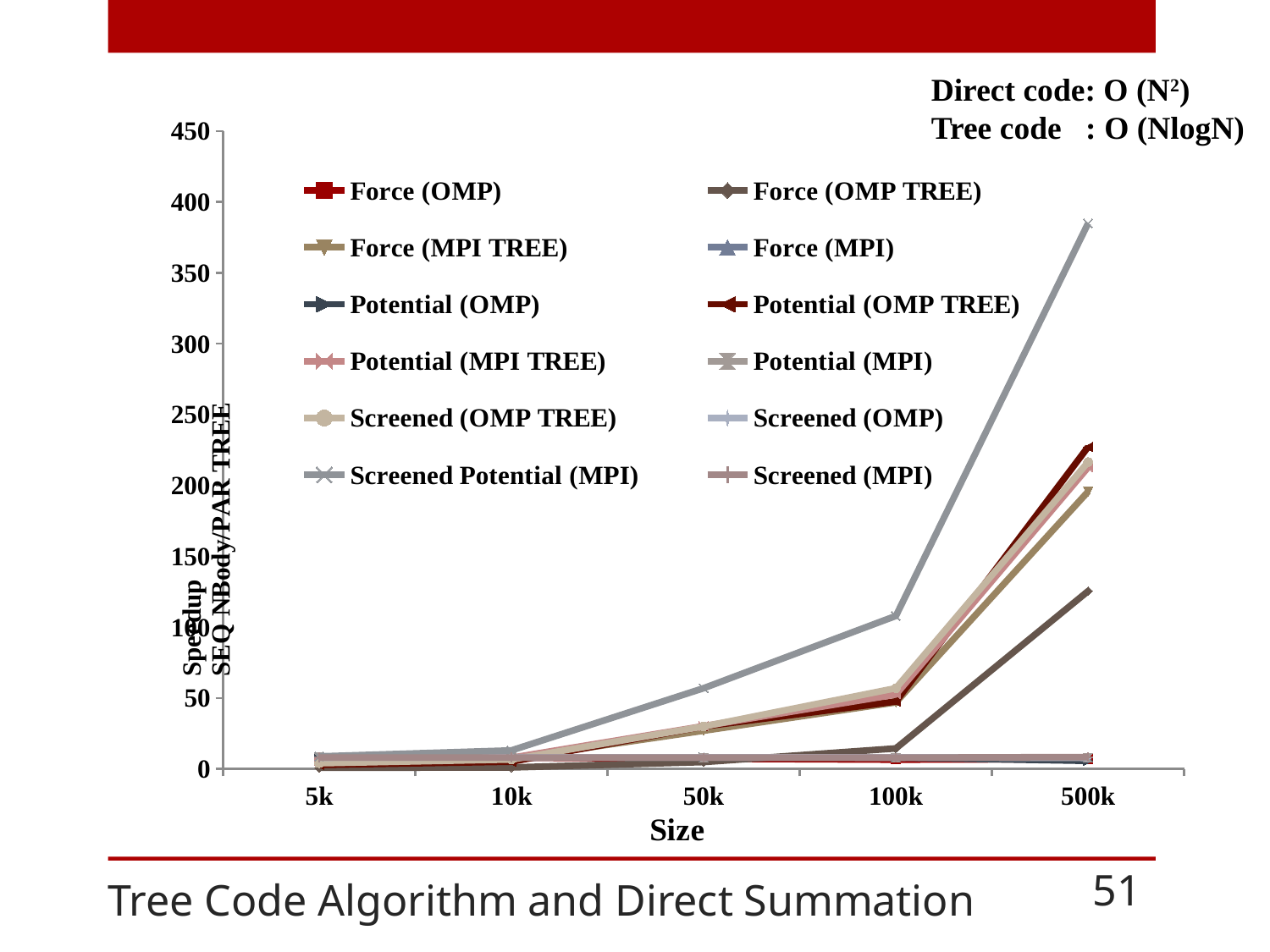
Is the value for Force (OMP TREE) at 500k greater or less than 100? greater At size 500k, which is larger: Screened Potential (MPI) or Force (OMP TREE)? Screened Potential (MPI) How many size categories are shown on the x axis? 5 Is the value for Force (OMP TREE) at 500k greater or less than 150? less Is the value for Screened Potential (MPI) at 100k greater or less than 50? greater What kind of chart is shown on the slide? line chart Does the Screened Potential (MPI) series rise or fall as size increases from 5k to 500k? rise What is the title of the x axis? Size What is the highest tick value shown on the y axis? 450 How many series does the legend list? 12 Which series has the highest value at size 500k? Screened Potential (MPI)